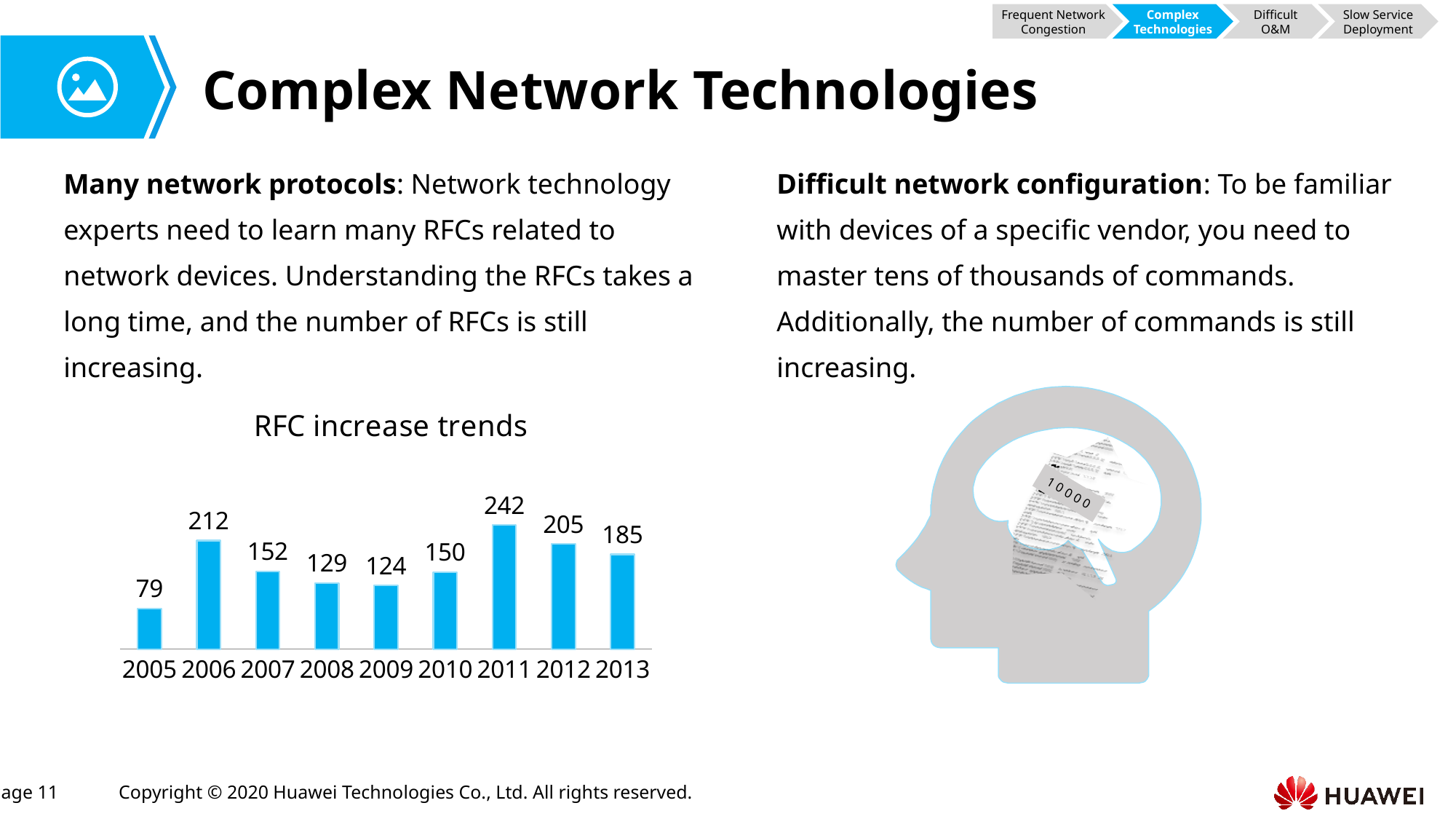
What is the value for 2013 in the RFC increase trends chart? 185 How many years are shown in the RFC increase trends chart? 9 What is the difference between the values for 2011 and 2012 in the RFC increase trends chart? 37 What is the title of the chart on the slide? RFC increase trends What kind of chart is the RFC increase trends chart? bar chart Which is larger in the RFC increase trends chart, the value for 2007 or the value for 2010? 2007 Do the values in the RFC increase trends chart rise or fall from 2011 to 2013? fall Which year has the lowest value in the RFC increase trends chart? 2005 What is the difference between the values for 2006 and 2005 in the RFC increase trends chart? 133 What is the value for 2011 in the RFC increase trends chart? 242 Which year has the highest value in the RFC increase trends chart? 2011 What is the value for 2005 in the RFC increase trends chart? 79